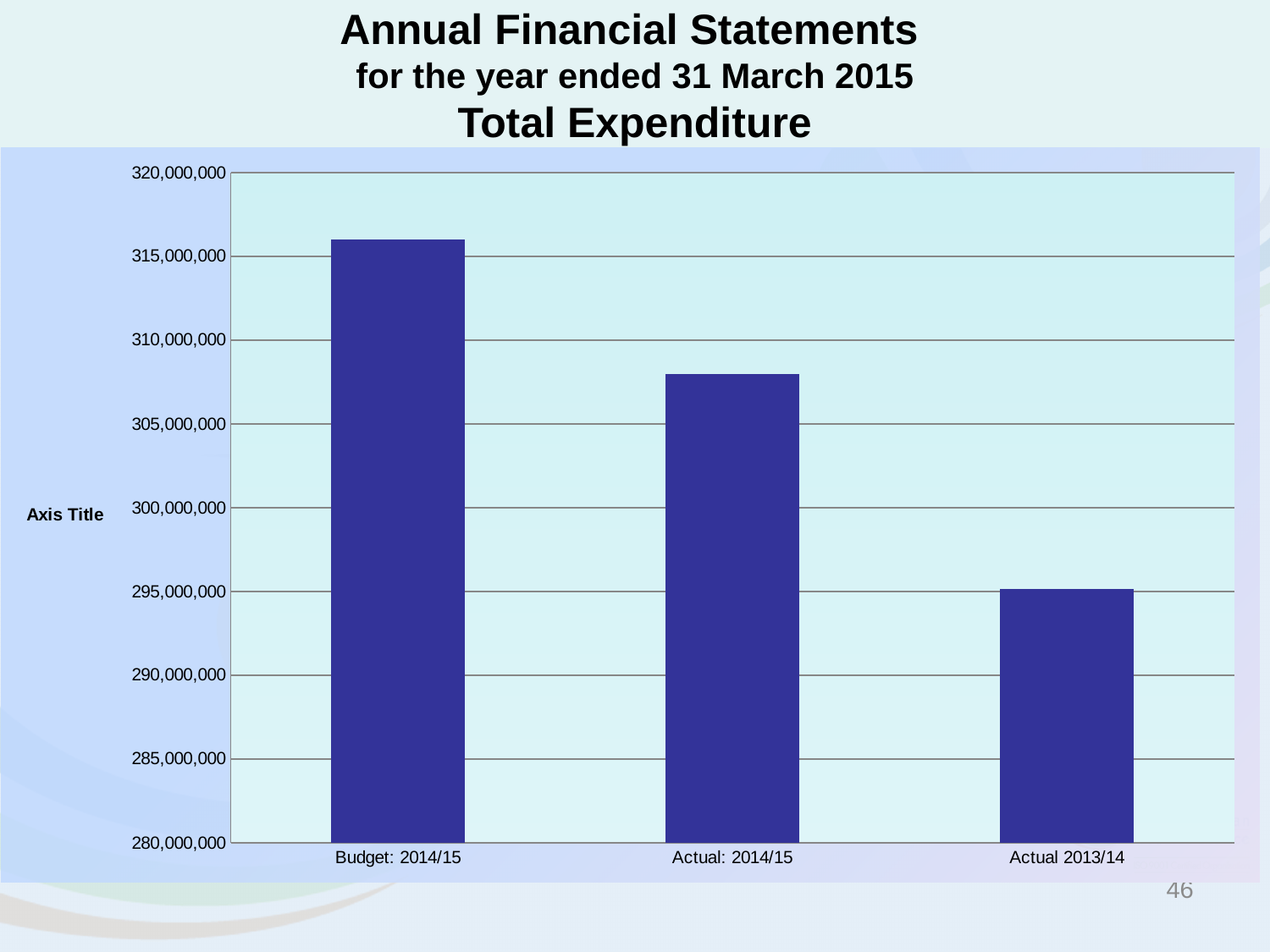
What is the lowest value shown on the vertical axis? 280,000,000 Is the value for Budget: 2014/15 greater or less than 315,000,000? greater Is the value for Actual: 2014/15 greater or less than 310,000,000? less What kind of chart is shown on the slide? bar chart Is the value for Actual 2013/14 greater or less than 300,000,000? less Which is larger, the value for Budget: 2014/15 or the value for Actual: 2014/15? Budget: 2014/15 Which category has the highest total expenditure? Budget: 2014/15 Which category has the lowest total expenditure? Actual 2013/14 How many bars are plotted in the chart? 3 What is the title of the chart on the slide? Total Expenditure Which is larger, the value for Actual: 2014/15 or the value for Actual 2013/14? Actual: 2014/15 Do the bar values rise or fall from left to right across the categories? fall